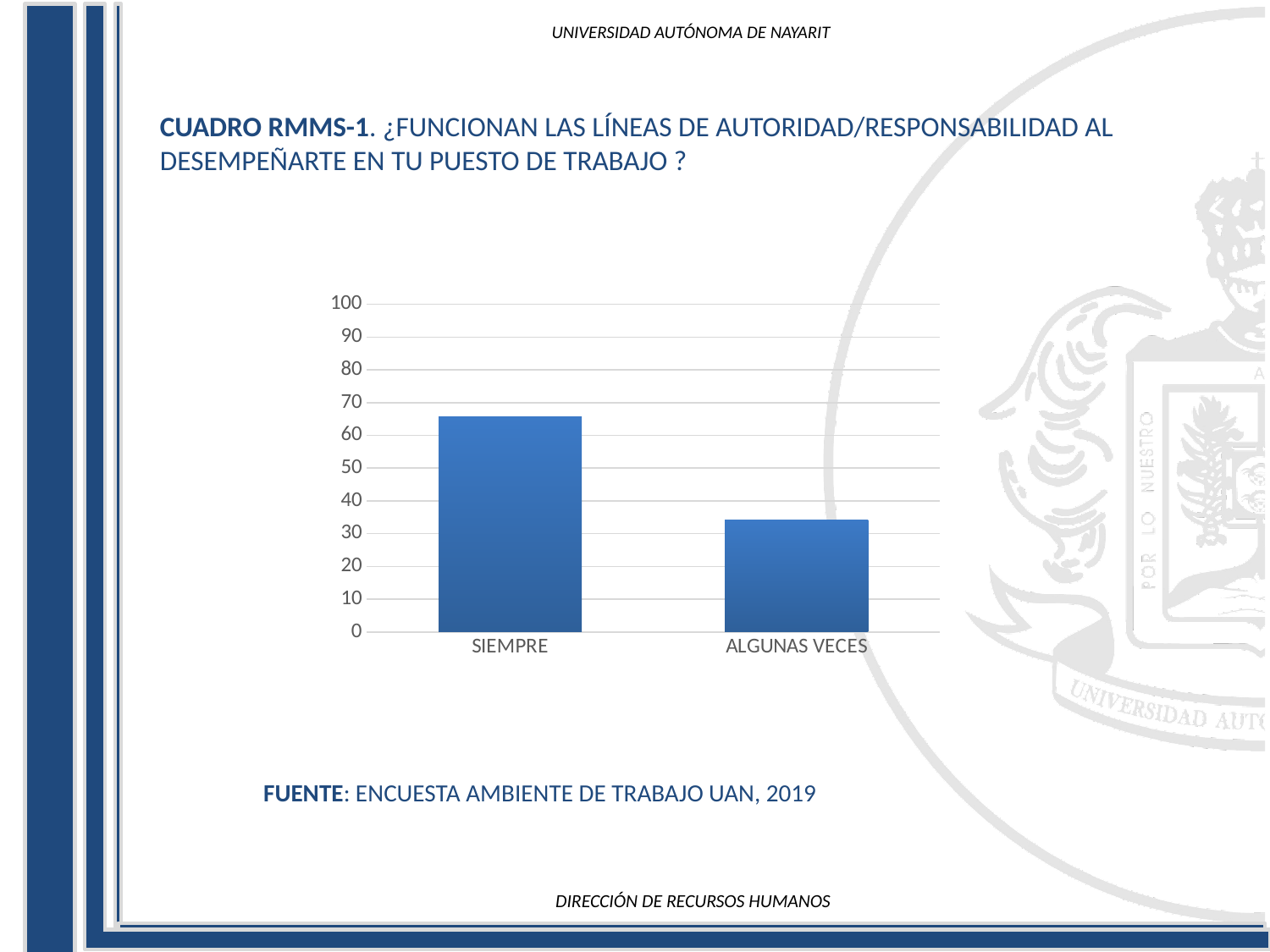
What kind of chart is shown on the slide? bar chart What source is cited below the chart? ENCUESTA AMBIENTE DE TRABAJO UAN, 2019 Which category has the lowest bar in the chart? ALGUNAS VECES Which category has the highest bar in the chart? SIEMPRE Is the value for SIEMPRE greater or less than 60? greater Is the value for SIEMPRE greater or less than 70? less Which is larger, the value for SIEMPRE or the value for ALGUNAS VECES? SIEMPRE Is the value for ALGUNAS VECES greater or less than 40? less What is the highest value shown on the vertical axis of the chart? 100 Do the bar values rise or fall from left to right along the x axis? fall How many categories are shown on the x axis of the chart? 2